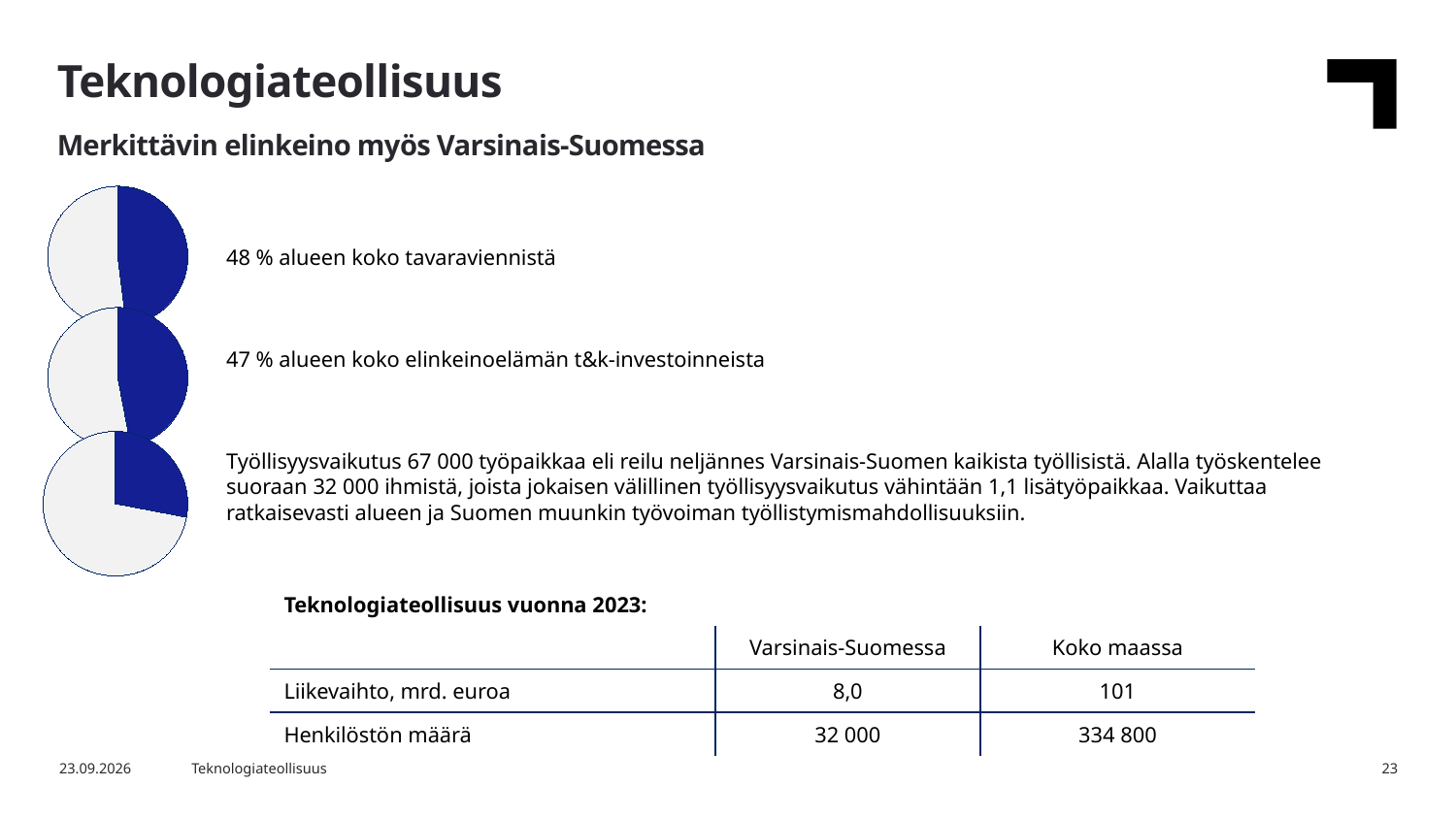
Which of the three pie charts has the smallest blue slice? The bottom pie chart How many pie charts are shown on the slide? 3 How many slices does the top pie chart have? 2 What kind of chart is the top chart on the left side of the slide? Pie chart What colour is the highlighted slice in each of the pie charts? Blue In the bottom pie chart, is the blue slice larger or smaller than the grey slice? Smaller In the top pie chart, what share does the blue slice represent according to the text beside it? 48 % In the middle pie chart, what share does the blue slice represent according to the text beside it? 47 % What does the blue slice of the top pie chart represent, according to the text next to it? 48 % alueen koko tavaraviennistä